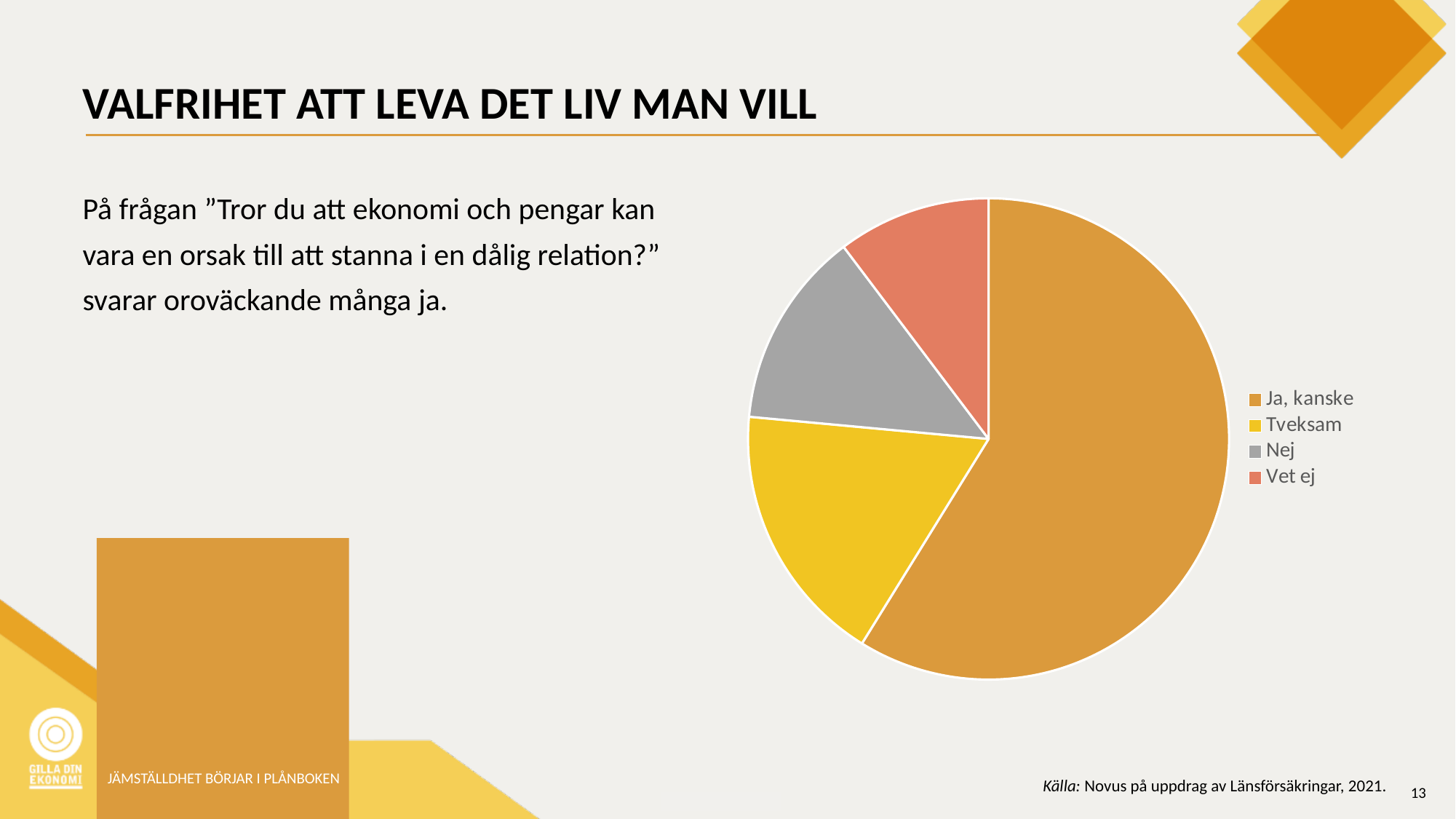
Which slice is larger in the pie chart, "Nej" or "Vet ej"? Nej Which slice is larger in the pie chart, "Tveksam" or "Nej"? Tveksam How many entries does the legend of the pie chart list? 4 Which slice is larger in the pie chart, "Ja, kanske" or "Tveksam"? Ja, kanske What colour is the "Tveksam" slice in the pie chart? Yellow What kind of chart is shown on the slide? Pie chart Which category in the legend is shown in grey? Nej Which category has the smallest slice in the pie chart? Vet ej How many slices does the pie chart have? 4 Which category has the largest slice in the pie chart? Ja, kanske